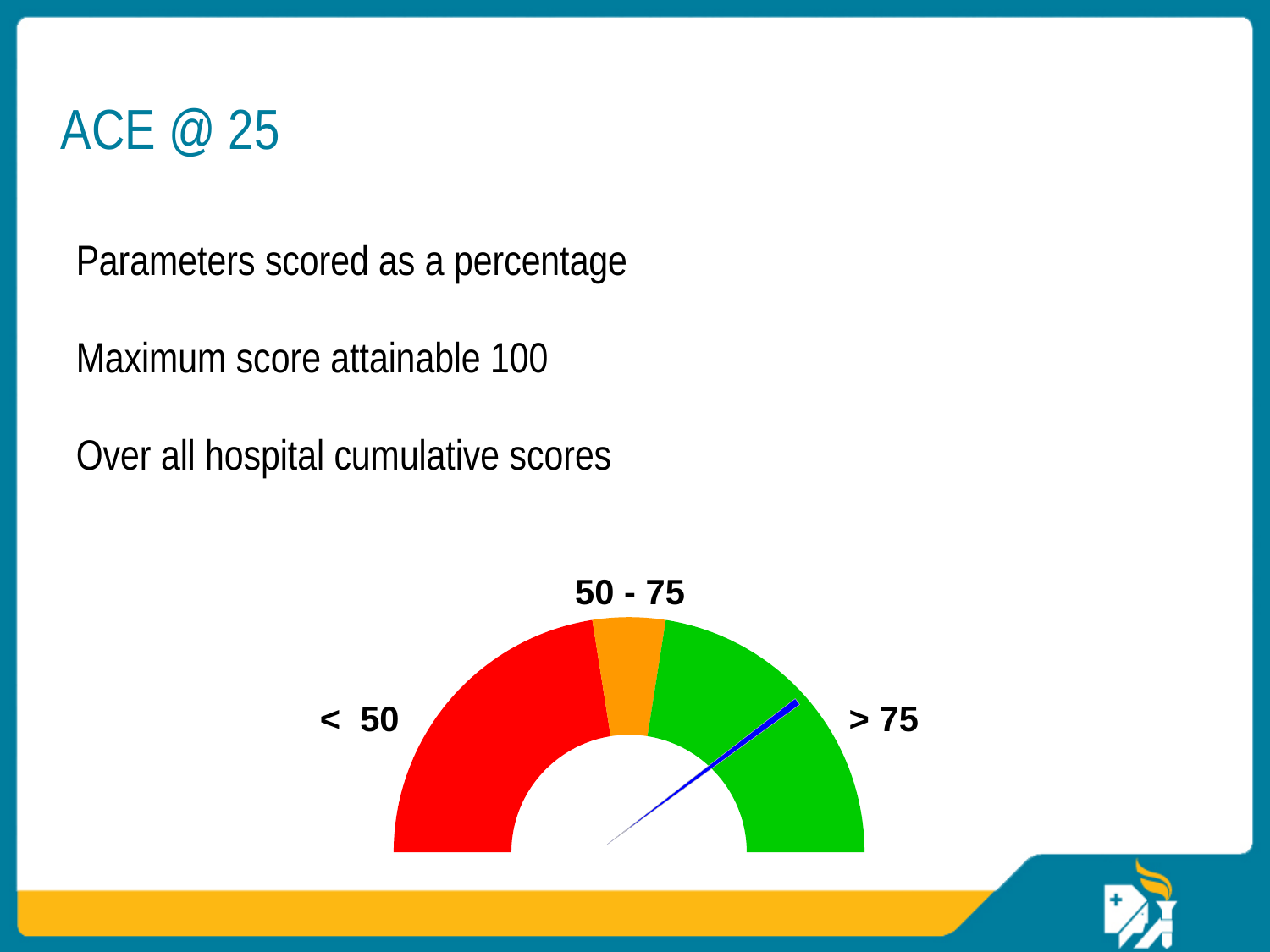
What colour is the "> 75" segment of the gauge? Green What is the label of the rightmost segment of the gauge? > 75 What is the label of the leftmost segment of the gauge? < 50 Which segment of the gauge does the needle point into? > 75 Which segment of the gauge is the smallest? 50 - 75 What is the label of the middle segment of the gauge? 50 - 75 Is the needle on the gauge pointing to a value greater or less than 50? greater What kind of chart is shown at the bottom of the slide? Gauge chart How many labelled segments does the gauge have? 3 What colour is the "< 50" segment of the gauge? Red